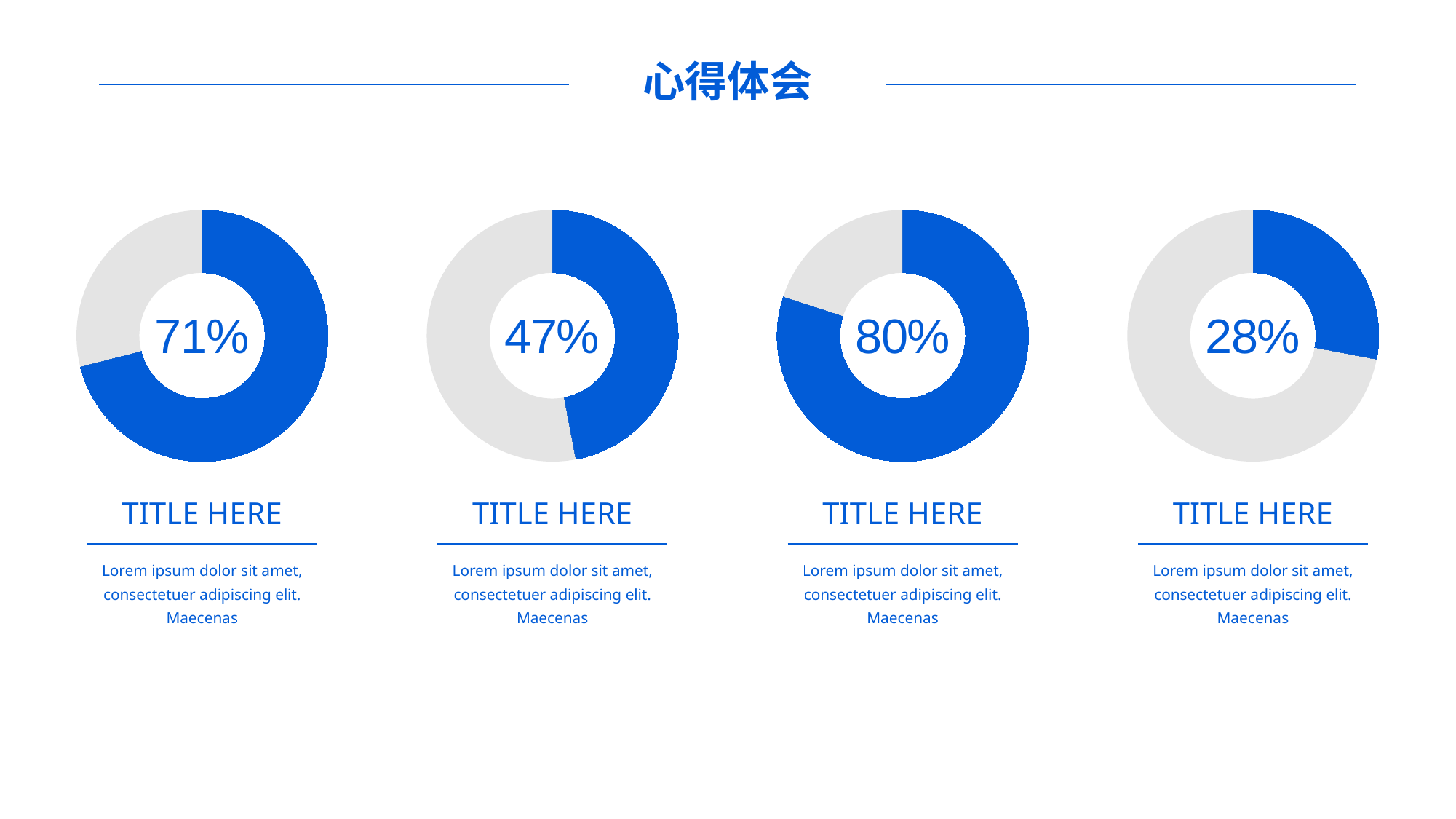
What percentage is shown in the centre of the rightmost donut chart? 28% Which of the four donut charts shows the highest percentage? The third from the left (80%) What percentage is shown in the centre of the second donut chart from the left? 47% What is the difference between the percentage in the leftmost donut chart and the percentage in the second donut chart? 24% What colour is used for the filled (percentage) portion of each donut chart? Blue Which is larger: the percentage in the leftmost donut chart or the percentage in the second donut chart? The leftmost (71%) What percentage is shown in the centre of the leftmost donut chart? 71% What kind of chart is used to display each percentage on the slide? Donut chart What percentage is shown in the centre of the third donut chart from the left? 80% How many donut charts are on the slide? 4 What is the difference between the percentage in the third donut chart and the percentage in the rightmost donut chart? 52% Which of the four donut charts shows the lowest percentage? The rightmost (28%)